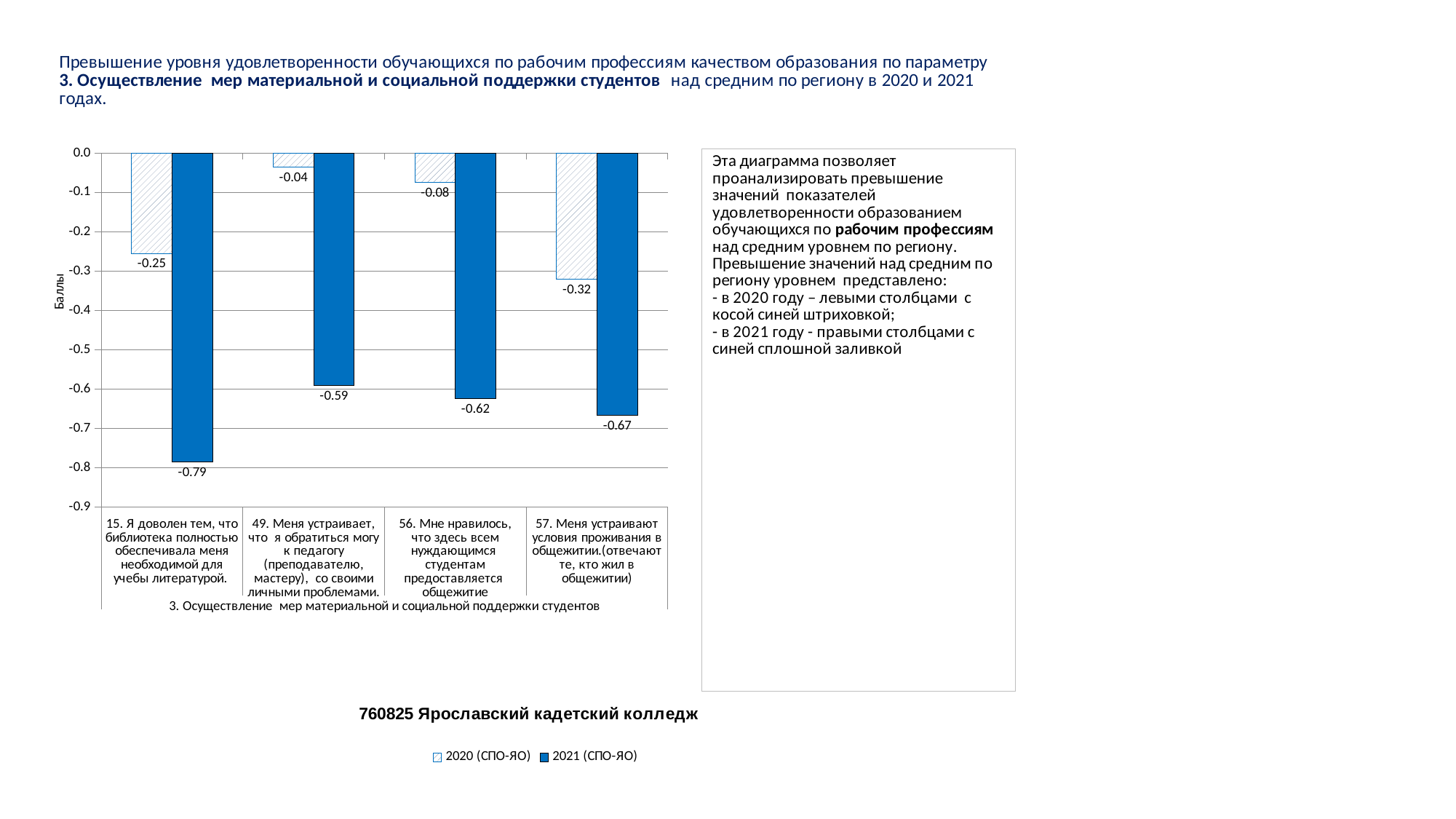
Which category has the highest value for the 2020 (СПО-ЯО) series? 49. Меня устраивает, что я обратиться могу к педагогу (преподавателю, мастеру), со своими личными проблемами. What is the value for 2020 (СПО-ЯО) for category 49 (approaching a teacher with personal problems)? -0.04 What is the value for 2020 (СПО-ЯО) for category 57 (dormitory living conditions)? -0.32 Which category has the lowest value for the 2021 (СПО-ЯО) series? 15. Я доволен тем, что библиотека полностью обеспечивала меня необходимой для учебы литературой. What is the value for 2021 (СПО-ЯО) for category 56 (dormitory provided to students in need)? -0.62 How many series does the legend list? 2 What kind of chart is shown on the slide? Bar chart How many categories are shown on the x axis? 4 What is the difference between the 2020 and 2021 values for category 15 (library literature)? 0.54 What is the label of the vertical axis? Баллы What is the value for 2021 (СПО-ЯО) for category 15 (library literature)? -0.79 Which is larger for category 57 (dormitory living conditions): the 2020 value or the 2021 value? 2020 (СПО-ЯО)